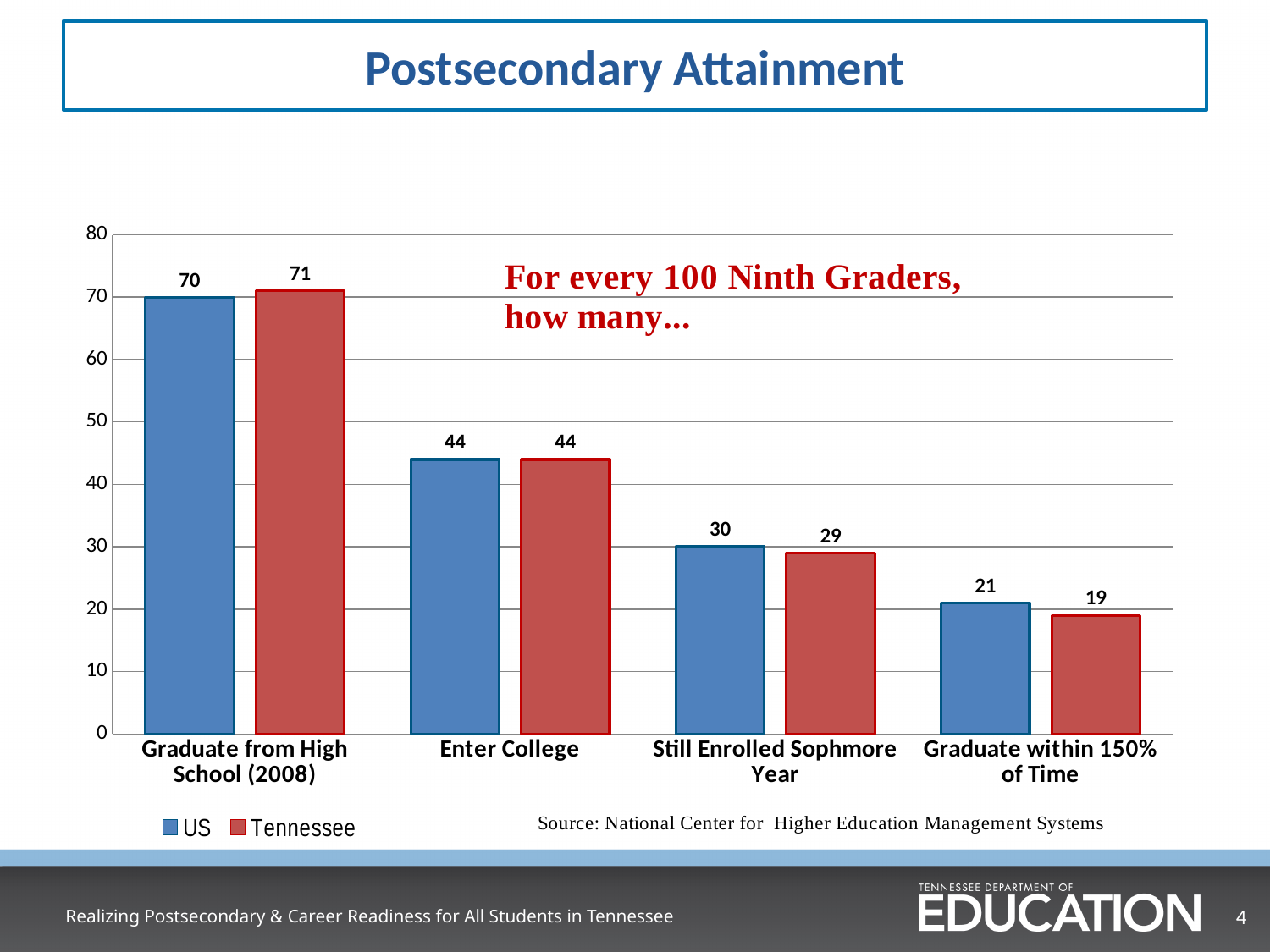
What is the difference between the US values for Enter College and Still Enrolled Sophmore Year? 14 Which category has the highest US value? Graduate from High School (2008) Which category has the lowest Tennessee value? Graduate within 150% of Time What is the Tennessee value for Graduate within 150% of Time? 19 What is the US value for Enter College? 44 What is the difference between the US and Tennessee values for Graduate within 150% of Time? 2 Which is larger for Still Enrolled Sophmore Year, the US value or the Tennessee value? US Do the Tennessee values rise or fall from left to right along the x axis? Fall How many series does the legend list? 2 What is the Tennessee value for Graduate from High School (2008)? 71 How many categories are shown on the x axis? 4 What kind of chart is shown on the slide? Bar chart